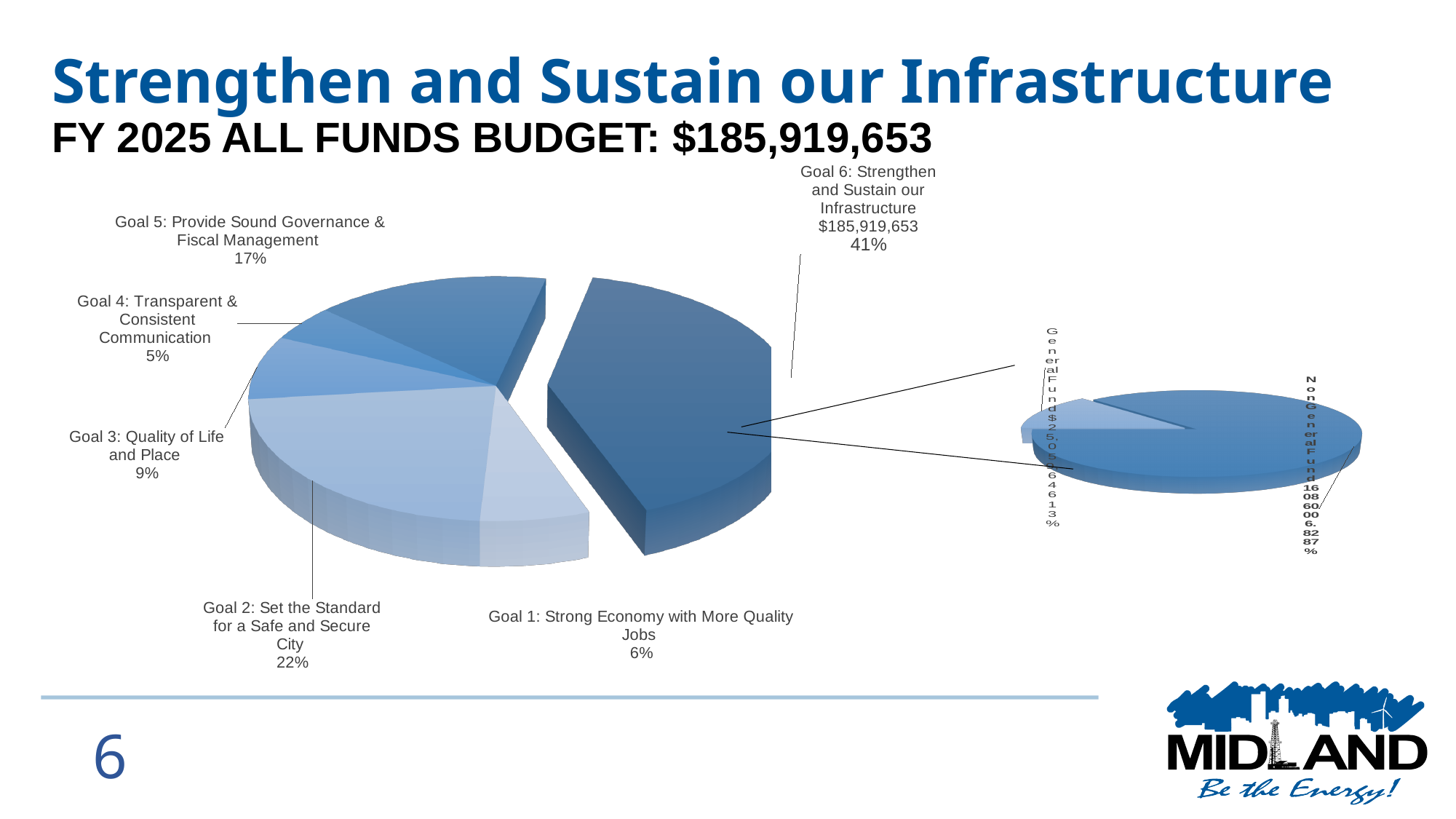
In the larger pie chart, what dollar amount is shown for Goal 6: Strengthen and Sustain our Infrastructure? $185,919,653 In the larger pie chart, which goal has the smallest share? Goal 4: Transparent & Consistent Communication In the larger pie chart, what percentage is shown for Goal 5: Provide Sound Governance & Fiscal Management? 17% How many goals (slices) are shown in the larger pie chart? 6 In the larger pie chart, how many percentage points larger is Goal 6's share than Goal 2's share? 19 percentage points In the larger pie chart, which has the larger share: Goal 3: Quality of Life and Place or Goal 1: Strong Economy with More Quality Jobs? Goal 3: Quality of Life and Place In the larger pie chart, how many percentage points larger is Goal 5's share than Goal 3's share? 8 percentage points What kind of chart is the larger chart on the slide? Pie chart In the larger pie chart, which slice is pulled out (exploded) from the rest of the pie? Goal 6: Strengthen and Sustain our Infrastructure In the larger pie chart, what percentage is shown for Goal 2: Set the Standard for a Safe and Secure City? 22% In the larger pie chart, which goal has the largest share? Goal 6: Strengthen and Sustain our Infrastructure In the larger pie chart, what percentage share is shown for Goal 6: Strengthen and Sustain our Infrastructure? 41%